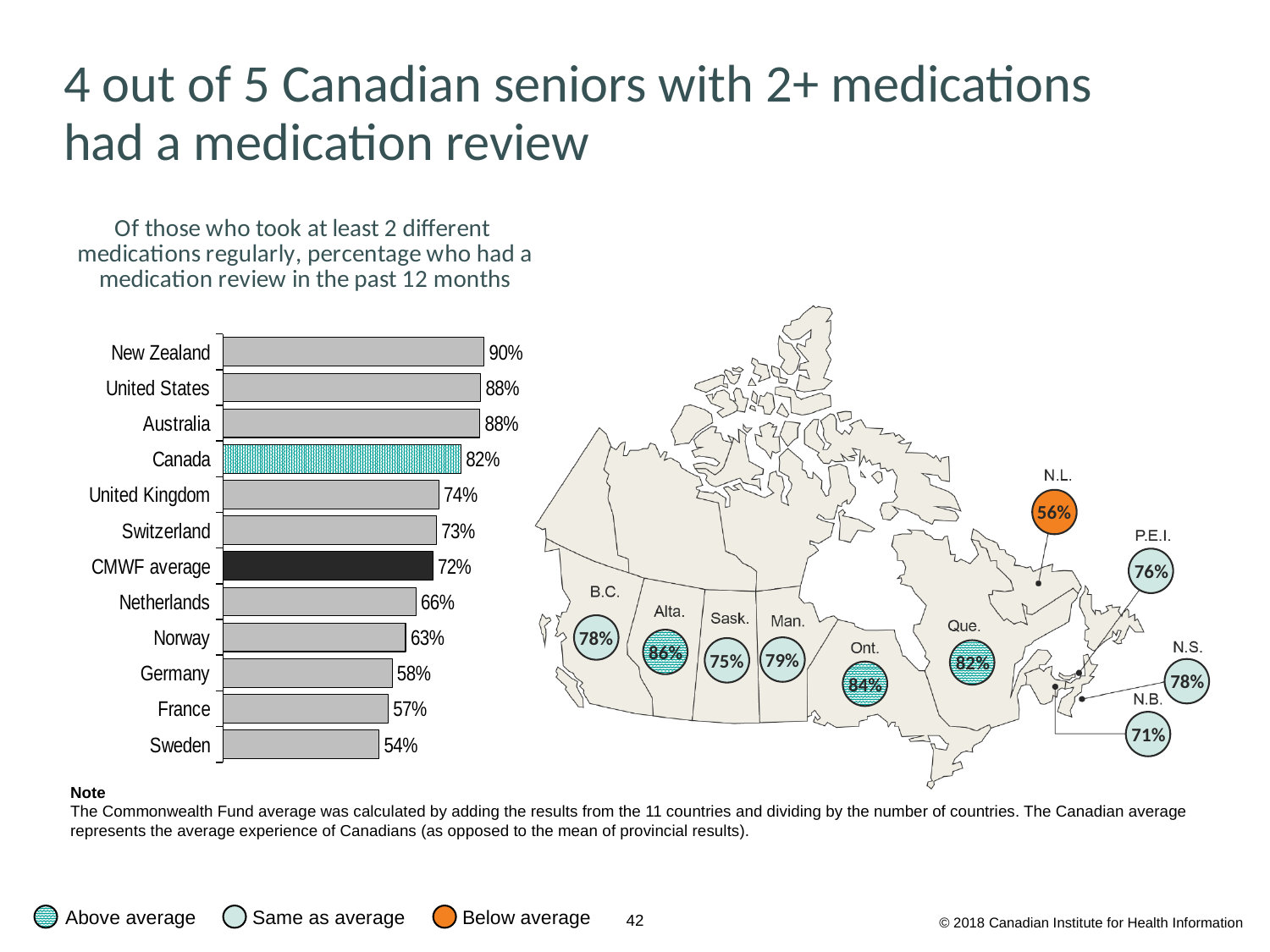
On the map of Canada, what is the value shown for Alberta (Alta.)? 86% In the bar chart, what is the difference in percentage points between New Zealand and Sweden? 36 percentage points How many bars are shown in the bar chart? 12 In the bar chart, what is the value for the CMWF average? 72% In the bar chart, which has a higher value, the United Kingdom or the Netherlands? United Kingdom In the bar chart, which country has the lowest percentage? Sweden On the map of Canada, which province has the lowest percentage? N.L. On the map of Canada, which province is marked as below average? N.L. In the bar chart, what is the value for Canada? 82% In the bar chart, what is the difference in percentage points between Canada and the CMWF average? 10 percentage points In the bar chart, which country has the highest percentage? New Zealand What kind of chart is used to show the country comparison on the left of the slide? Bar chart